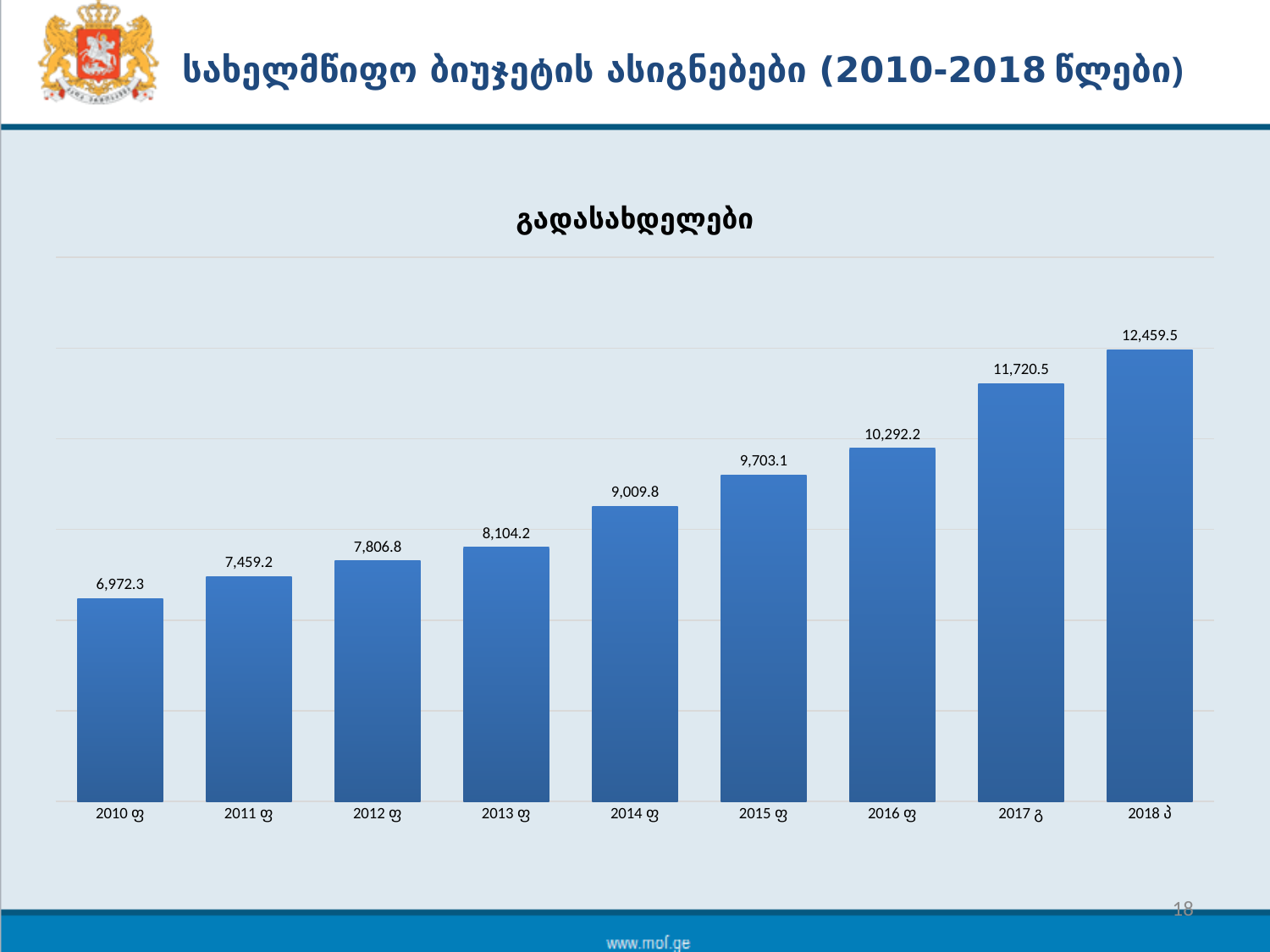
What is the difference between the values for 2011 and 2010? 486.9 Which year has the highest value? 2018 What is the title of the chart? გადასახდელები What is the value shown for 2010? 6,972.3 What is the value shown for 2017? 11,720.5 What type of chart is shown on the slide? Bar chart How many bars are shown in the chart? 9 What is the difference between the values for 2018 and 2017? 739.0 What is the value shown for 2014? 9,009.8 Which year has the lowest value? 2010 Do the values rise or fall from 2010 to 2018? Rise Which is larger, the value for 2015 or the value for 2013? 2015